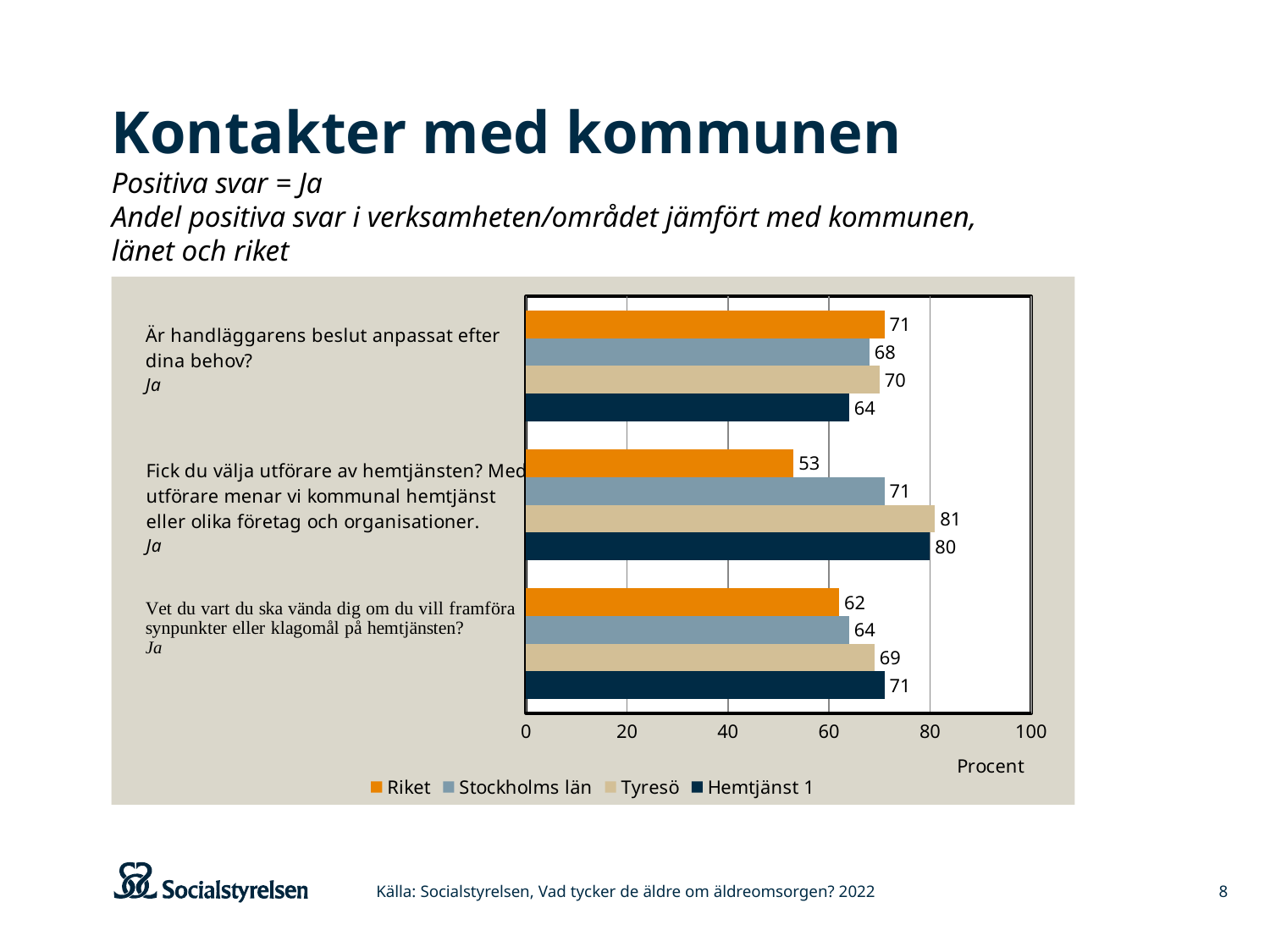
What type of chart is shown on the slide? Bar chart Is the value for Riket on the question 'Fick du välja utförare av hemtjänsten?' greater or less than 60? less What is the value for Riket on the question 'Är handläggarens beslut anpassat efter dina behov?' 71 Which series has the lowest value on the question 'Är handläggarens beslut anpassat efter dina behov?' Hemtjänst 1 Which series has the highest value on the question 'Fick du välja utförare av hemtjänsten?' Tyresö What is the value for Tyresö on the question 'Vet du vart du ska vända dig om du vill framföra synpunkter eller klagomål på hemtjänsten?' 69 What label is shown on the horizontal axis of the chart? Procent How many series does the legend list? 4 How many question categories are plotted on the chart? 3 What is the difference between Tyresö and Riket on the question 'Fick du välja utförare av hemtjänsten?' 28 Which is larger on the question 'Vet du vart du ska vända dig om du vill framföra synpunkter eller klagomål på hemtjänsten?': Hemtjänst 1 or Riket? Hemtjänst 1 What is the value for Hemtjänst 1 on the question 'Fick du välja utförare av hemtjänsten?' 80